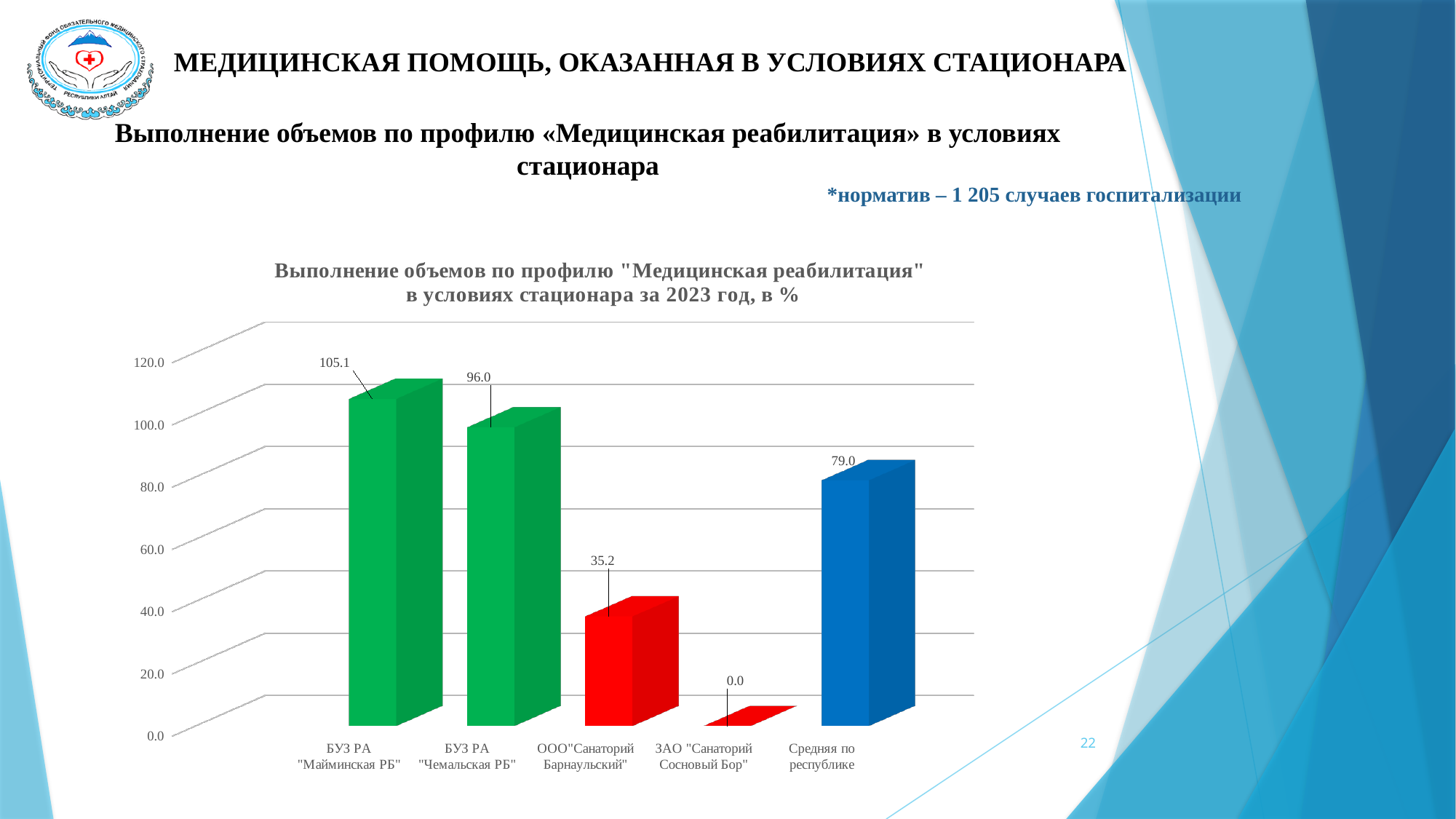
What is the value for Средняя по республике? 79.0 Which category has the highest value? БУЗ РА "Майминская РБ" What is the value for БУЗ РА "Чемальская РБ"? 96.0 What is the value for БУЗ РА "Майминская РБ"? 105.1 What colour is the bar for Средняя по республике? Blue Which is larger, the value for ООО"Санаторий Барнаульский" or the value for Средняя по республике? Средняя по республике What is the value for ЗАО "Санаторий Сосновый Бор"? 0.0 Which category has the lowest value? ЗАО "Санаторий Сосновый Бор" What kind of chart is shown on the slide? Bar chart What is the difference between the values for БУЗ РА "Майминская РБ" and БУЗ РА "Чемальская РБ"? 9.1 What is the value for ООО"Санаторий Барнаульский"? 35.2 How many categories are shown on the chart? 5